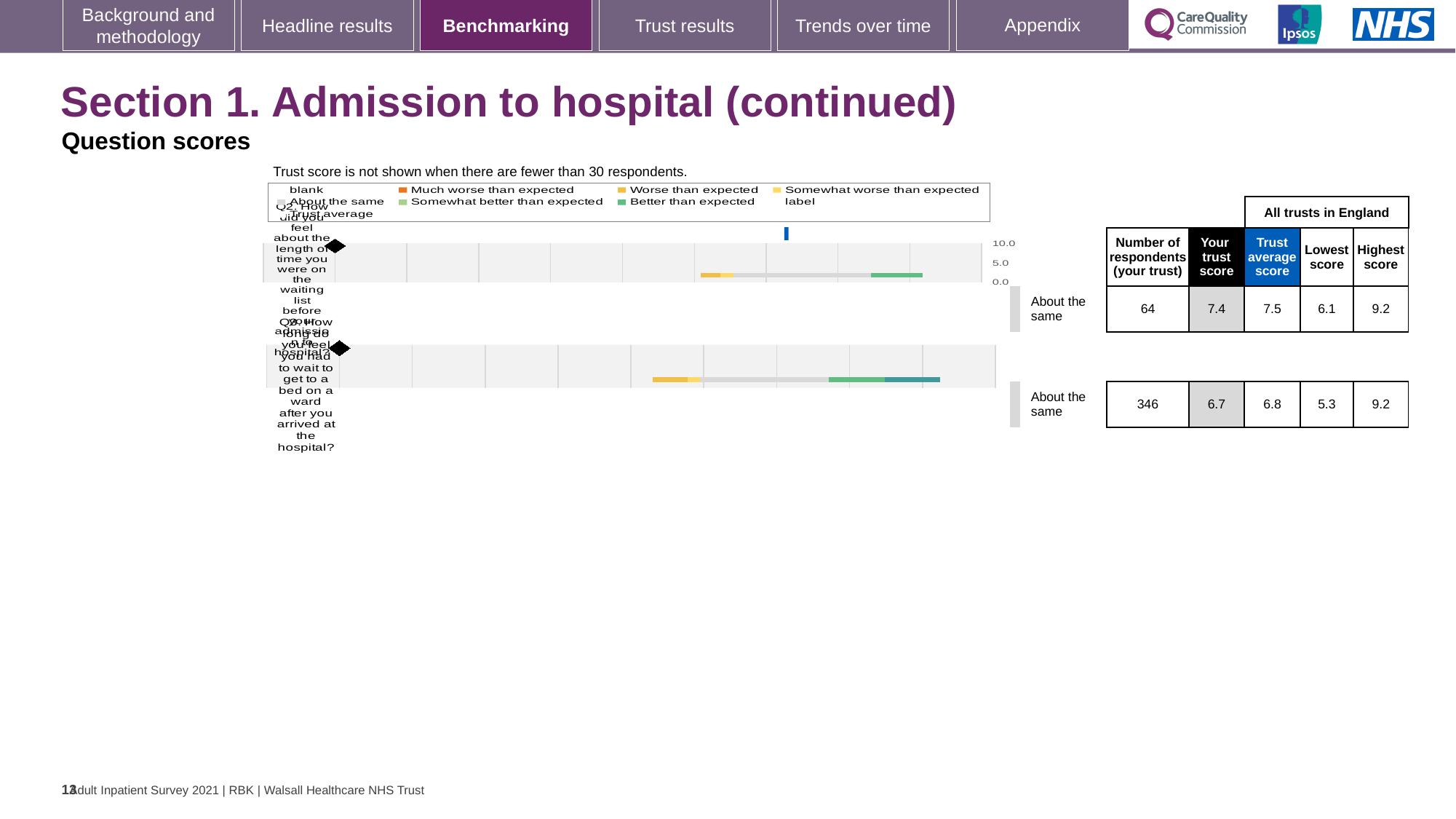
What is the trust score for Q2 (length of time on the waiting list before admission)? 7.4 How many respondents answered Q3 for this trust? 346 How many questions are plotted in the question scores chart? 2 By how much does the trust average score exceed this trust's score for Q2? 0.1 What is the difference between the highest score and the lowest score for Q3? 3.9 What kind of chart is used to show the question scores on this slide? bar chart How many respondents answered Q2 for this trust? 64 Which question has the higher trust score for this trust, Q2 or Q3? Q2 What is the lowest score among all trusts in England for Q2? 6.1 What benchmark category is shown for Q3 on this slide? About the same What is the trust average score across all trusts in England for Q3? 6.8 What is the trust score for Q3 (wait to get to a bed on a ward after arriving at the hospital)? 6.7